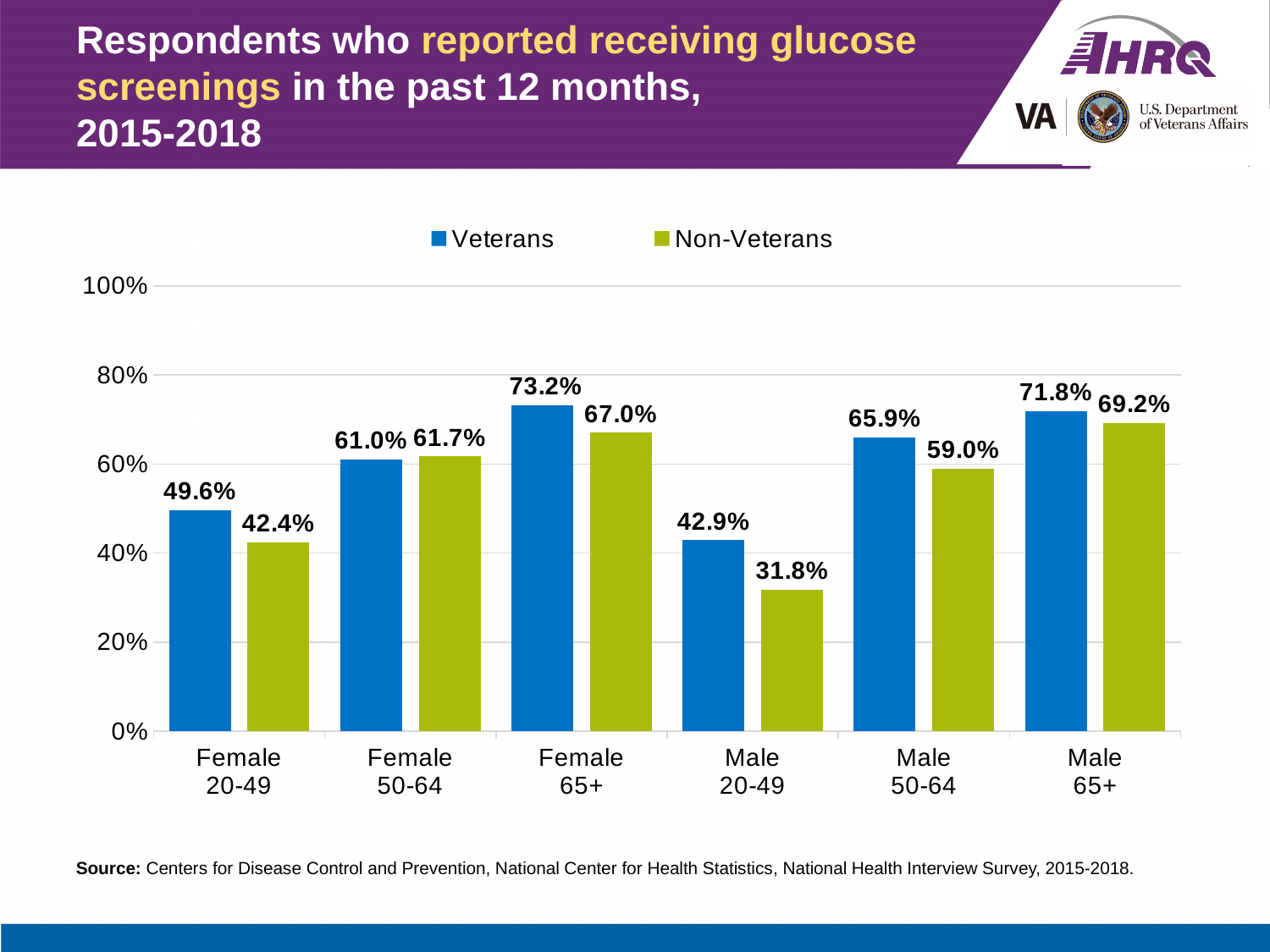
What is the difference between Veterans and Non-Veterans in the Female 20-49 group? 7.2% What is the value for Veterans in the Male 50-64 group? 65.9% What kind of chart is shown on the slide? Bar chart In the Female 50-64 group, which is larger: Veterans or Non-Veterans? Non-Veterans What is the difference between Veterans and Non-Veterans in the Male 20-49 group? 11.1% How many series does the legend list? 2 What percentage of Female 65+ Veterans reported receiving glucose screenings? 73.2% Which group has the highest value for Veterans? Female 65+ What is the value for Non-Veterans in the Male 20-49 group? 31.8% Is the value for Male 65+ Veterans greater or less than 60%? greater Which group has the lowest value for Non-Veterans? Male 20-49 How many age-sex groups are shown on the x axis? 6